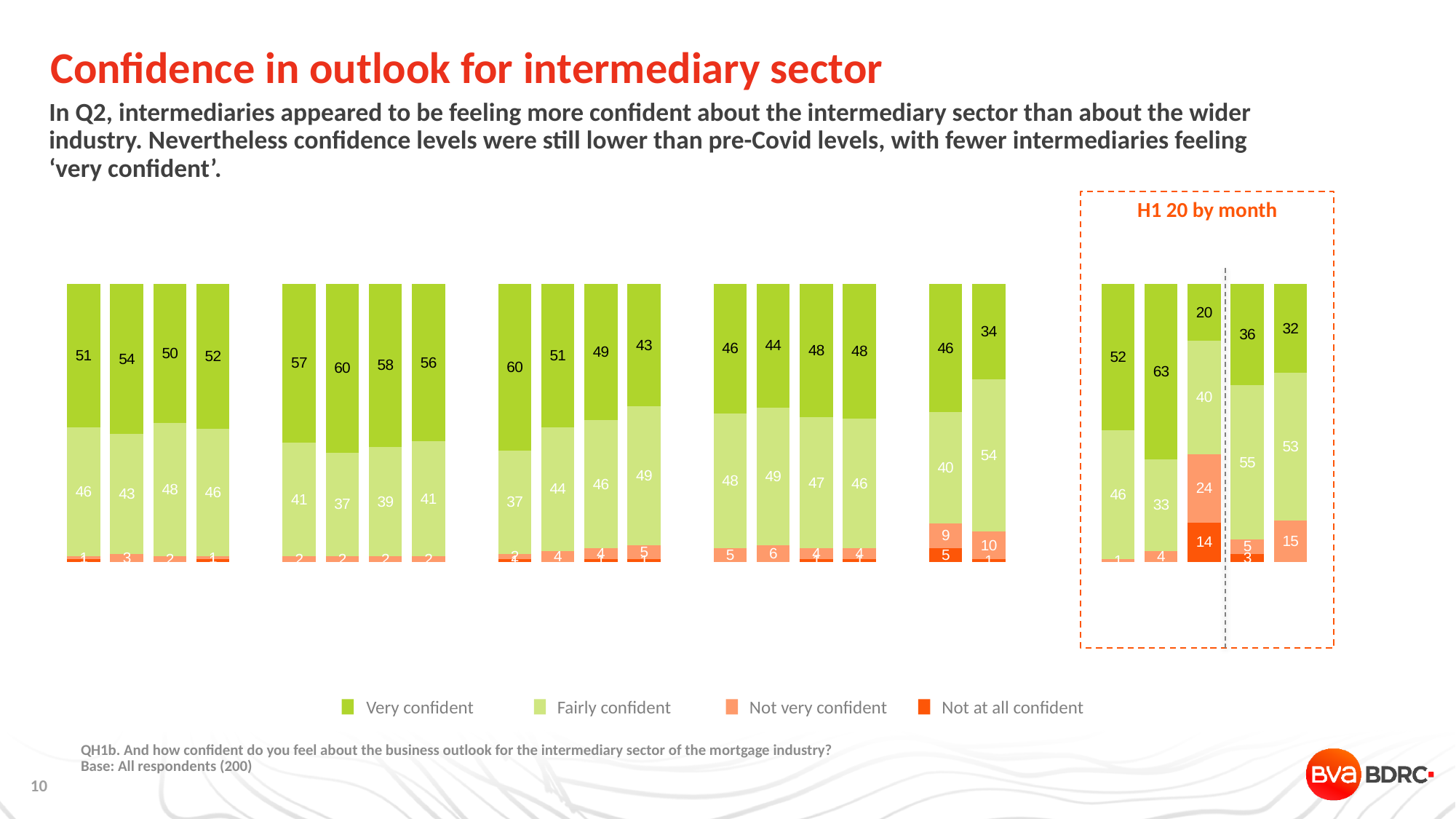
What is the 'Very confident' value for the rightmost bar in the 'H1 20 by month' section? 32 What is the title of the chart section outlined with a dashed orange box? H1 20 by month What kind of chart is shown on the slide? Stacked bar chart What is the 'Fairly confident' value for the rightmost bar in the 'H1 20 by month' section? 53 What are the four legend entries of the chart? Very confident, Fairly confident, Not very confident, Not at all confident What is the 'Not at all confident' value for the middle bar in the 'H1 20 by month' section? 14 What is the lowest 'Very confident' value shown on any bar in the chart? 20 What is the highest 'Very confident' value shown on any bar in the chart? 63 What is the difference between the 'Very confident' values of the second bar (63) and the middle bar (20) in the 'H1 20 by month' section? 43 How many series does the legend list? 4 How many bars are inside the 'H1 20 by month' dashed box? 5 In the 'H1 20 by month' section, which is larger: the 'Very confident' value of the second bar (63) or of the middle bar (20)? The second bar (63)